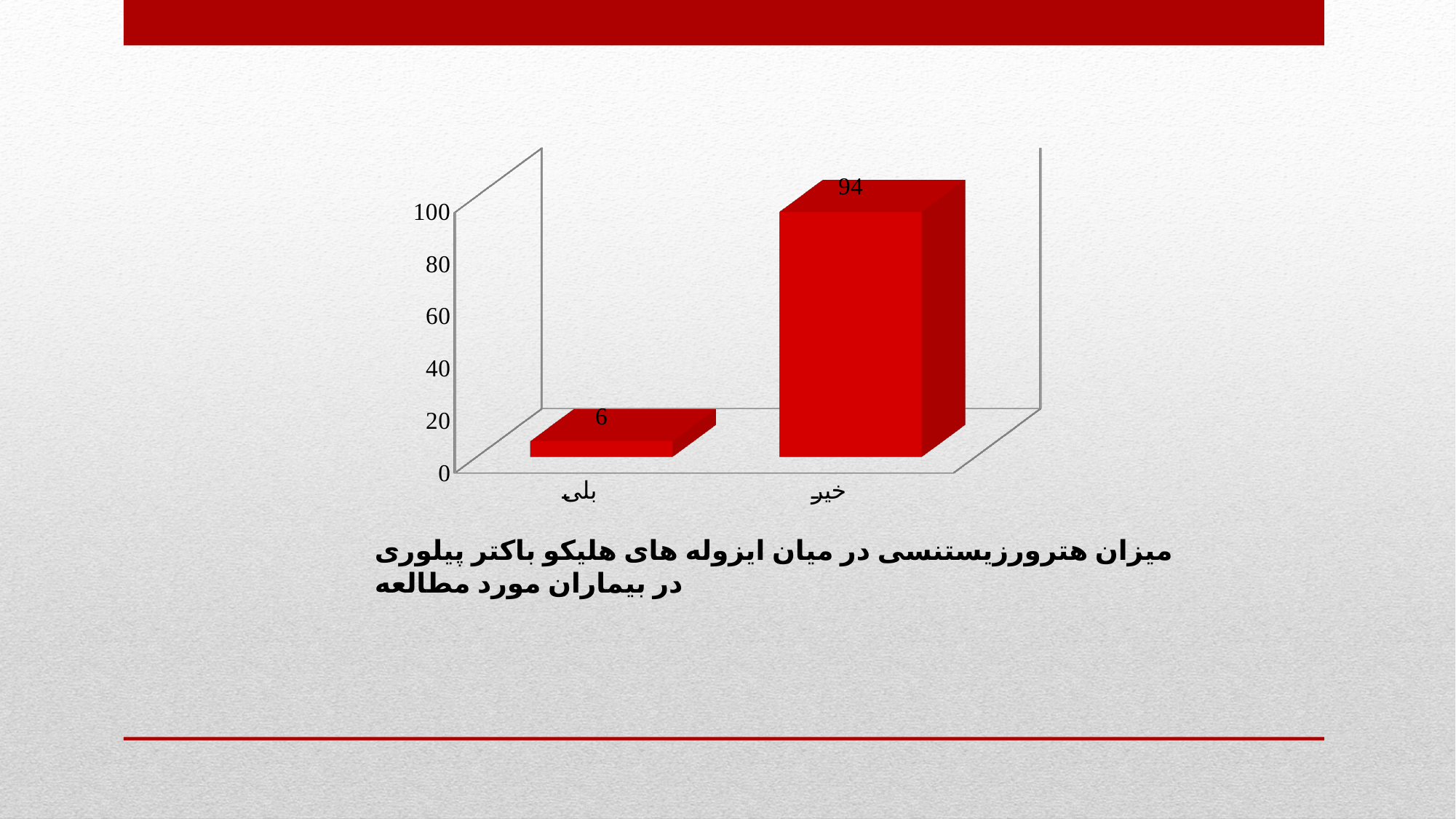
What is the value for خیر? 94 How many categories are shown on the x axis? 2 What kind of chart is shown on the slide? bar chart Which category has the lowest value? بلی Is the value for خیر greater or less than 80? greater What colour are the bars in the chart? red Which is larger, the value for بلی or the value for خیر? خیر What is the difference between the values for خیر and بلی? 88 What is the value for بلی? 6 Is the value for بلی greater or less than 20? less Which category has the highest value? خیر What is the total of the two bar values? 100